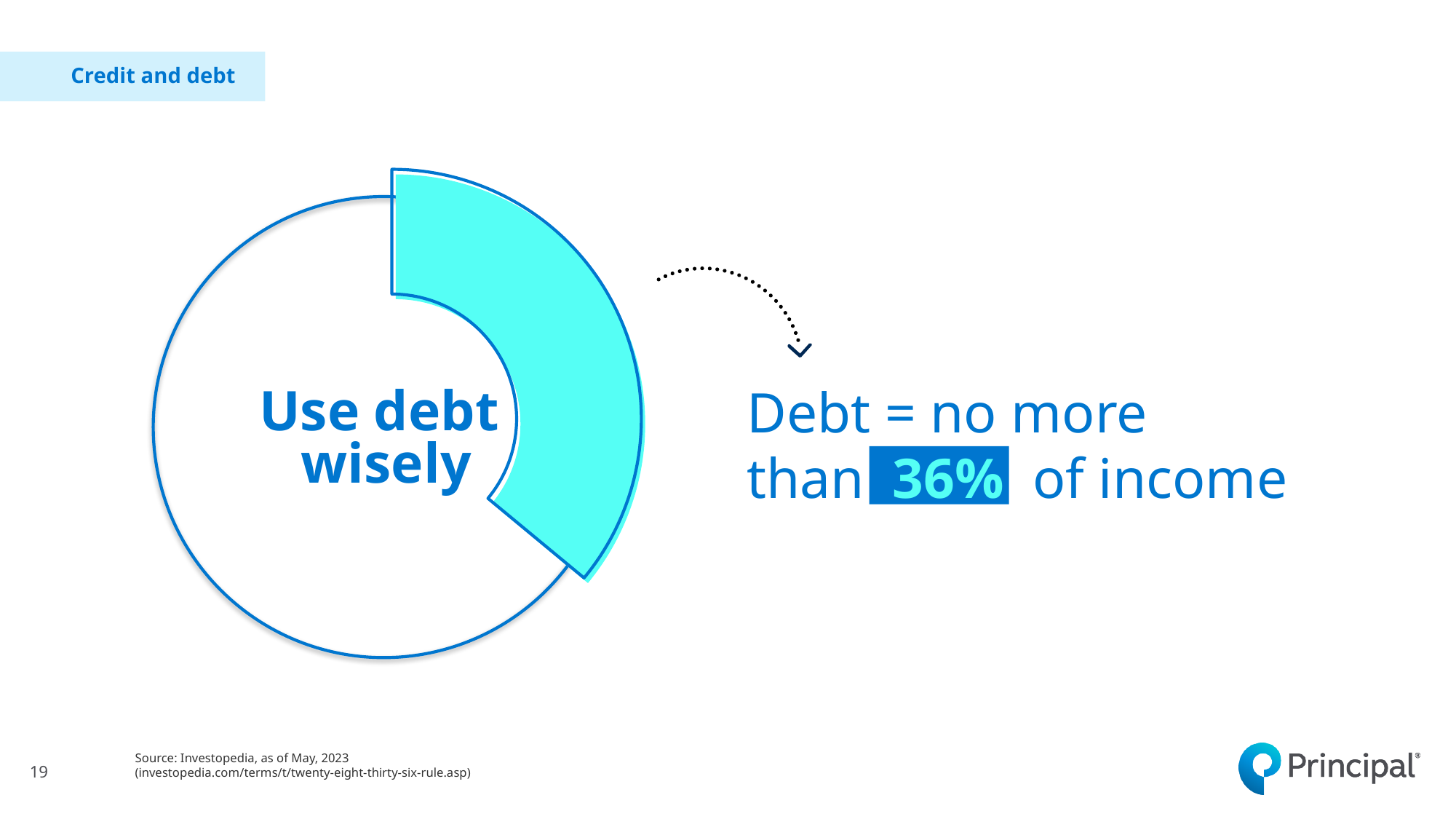
What share of income does the highlighted slice of the pie chart represent? 36% According to the slide, debt should be no more than what percentage of income? 36% What kind of chart is shown on the slide? pie chart What is the section heading shown at the top left of the slide? Credit and debt How many slices of the pie chart are highlighted in colour? 1 Is the highlighted slice of the pie chart greater or less than half of the pie? less What text is written in the centre of the pie chart? Use debt wisely